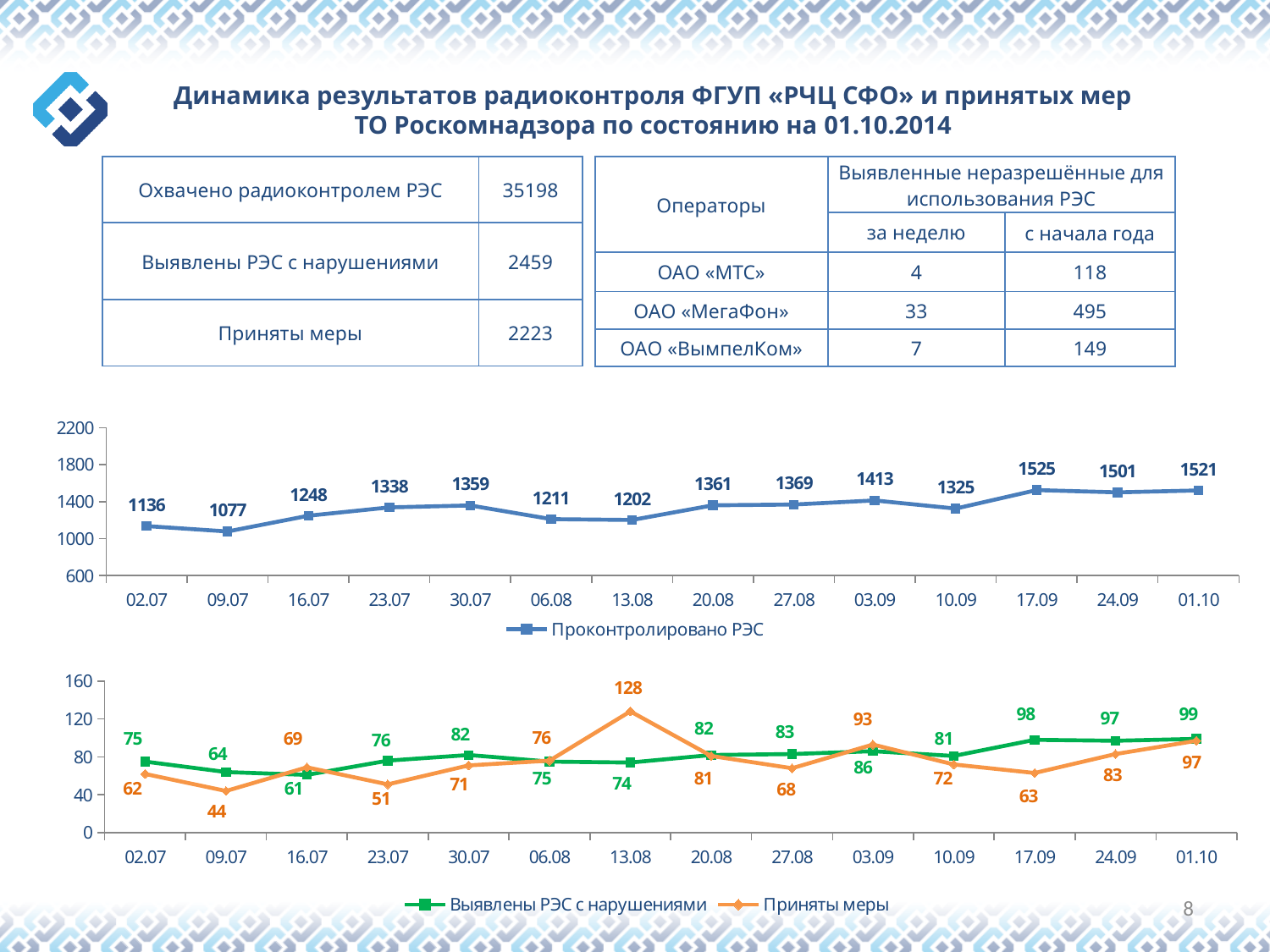
How many series does the legend of the bottom chart list? 2 In the bottom chart, which is larger on 03.09: Выявлены РЭС с нарушениями or Приняты меры? Приняты меры In the top chart, what is the value of Проконтролировано РЭС on 02.07? 1136 In the top chart, on which date is Проконтролировано РЭС lowest? 09.07 In the bottom chart, what is the difference between Приняты меры and Выявлены РЭС с нарушениями on 13.08? 54 How many data points are plotted in the top chart? 14 What type of chart is the top chart? line chart In the bottom chart, what is the value of Приняты меры on 13.08? 128 In the top chart, what is the difference between the values on 01.10 and 02.07? 385 In the top chart, on which date is Проконтролировано РЭС highest? 17.09 In the bottom chart, on which date is Приняты меры lowest? 09.07 In the bottom chart, what is the value of Выявлены РЭС с нарушениями on 17.09? 98